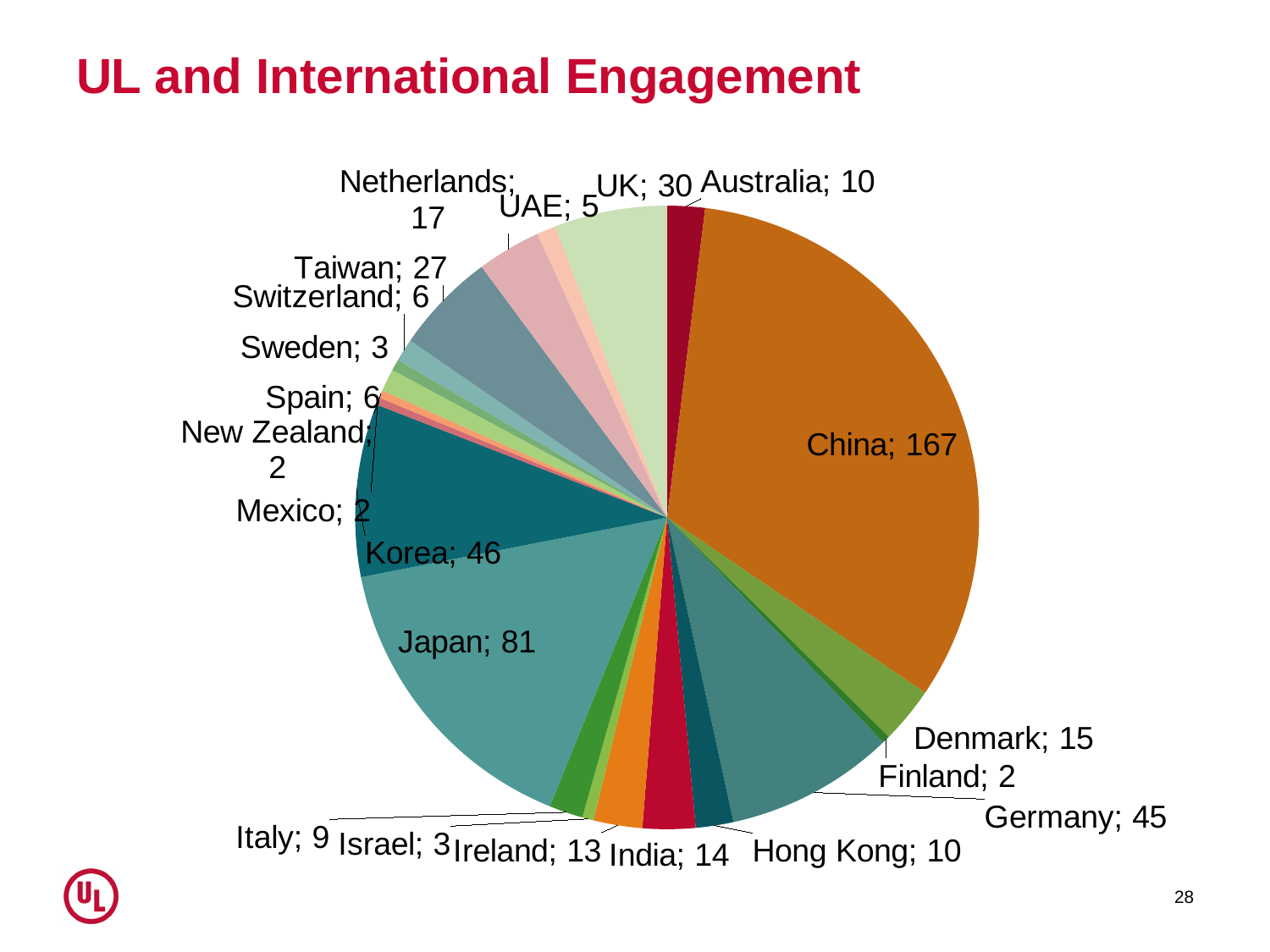
What is the difference between the values for China and Germany? 122 What is the value for Taiwan? 27 What is the value for Netherlands? 17 What kind of chart is shown on the slide? pie chart Which country has the largest slice of the pie? China What is the value for Japan? 81 What is the value for China? 167 What is the difference between the values for Japan and Korea? 35 Which is larger, the value for Germany or the value for Korea? Korea What is the title of the slide containing the pie chart? UL and International Engagement Which is larger, the value for UK or the value for Taiwan? UK How many countries are shown in the pie chart? 21